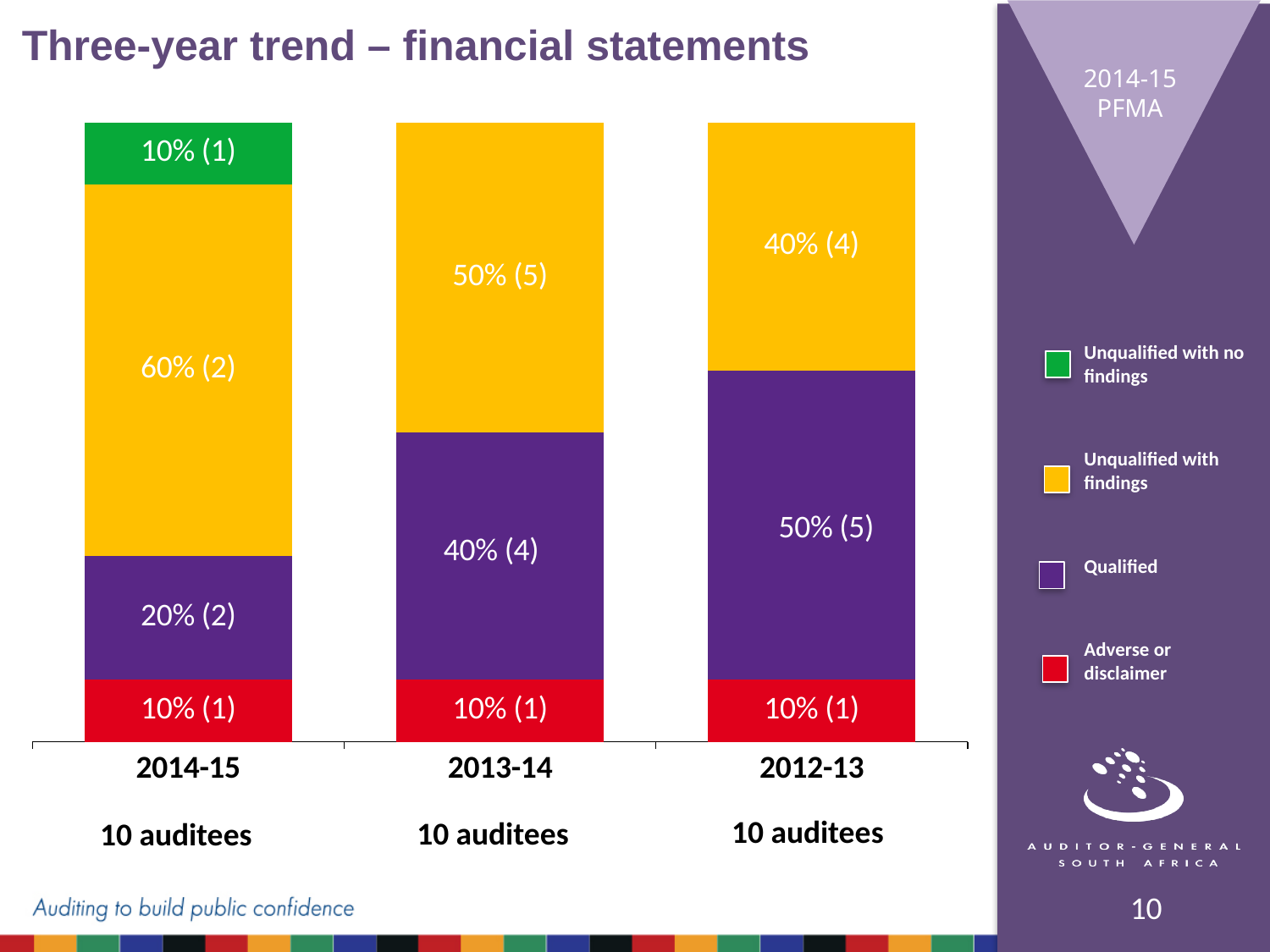
What kind of chart is shown on the slide? Stacked bar chart Which is larger in 2012-13: Qualified or Unqualified with findings? Qualified Which colour represents Adverse or disclaimer in the legend? Red What is the value for Unqualified with findings in 2014-15? 60% (2) What is the value for Unqualified with no findings in 2014-15? 10% (1) How many years (categories) are shown on the x axis? 3 Does the Qualified share rise or fall moving left to right along the x axis from 2014-15 to 2012-13? Rise How many series does the legend list? 4 What is the value for Qualified in 2012-13? 50% (5) What is the difference in percentage points between Unqualified with findings and Qualified in 2013-14? 10 percentage points What is the value for Qualified in 2013-14? 40% (4) What is the value for Adverse or disclaimer in 2012-13? 10% (1)